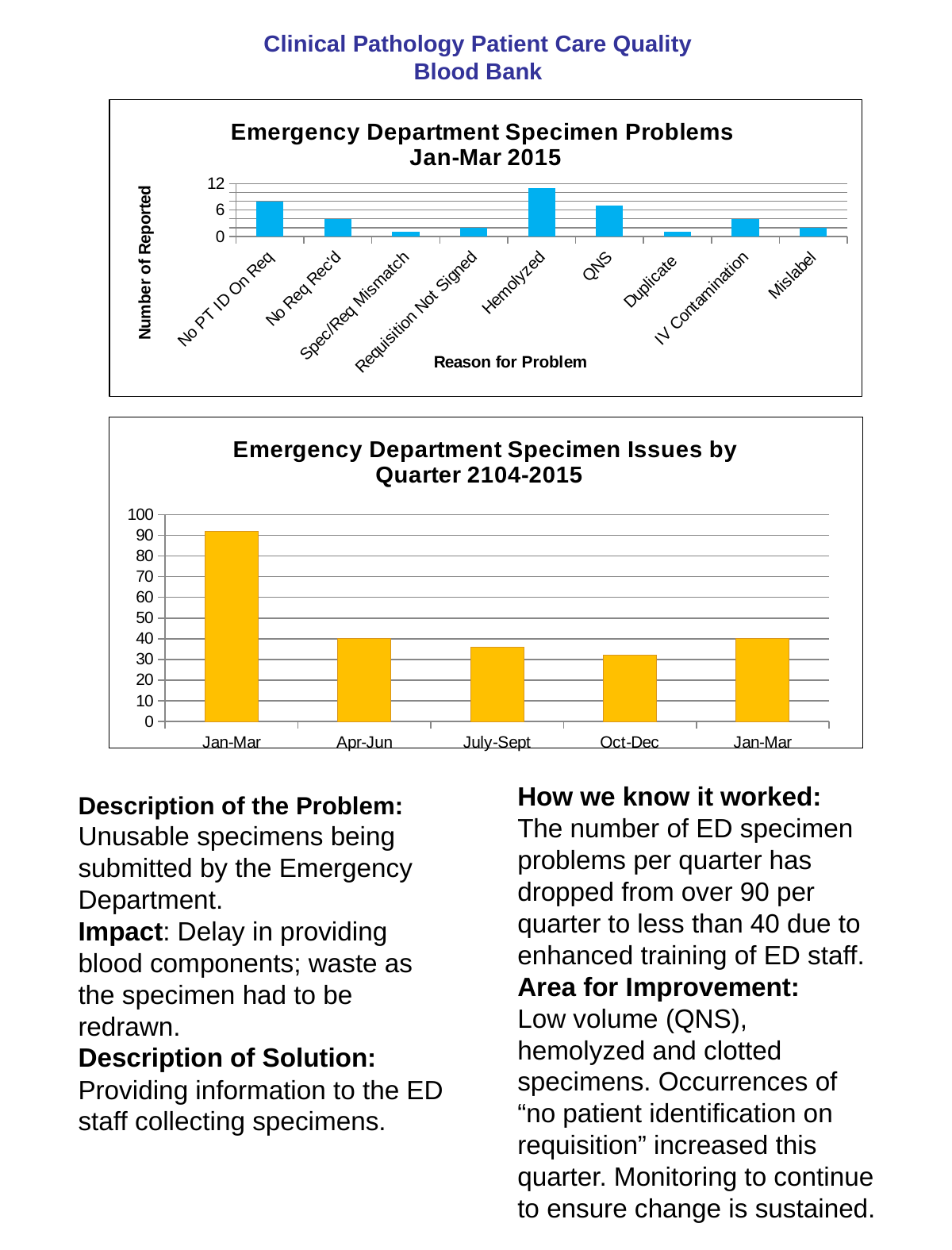
In the top chart 'Emergency Department Specimen Problems Jan-Mar 2015', how many reasons for problem are shown on the x axis? 9 In the top chart 'Emergency Department Specimen Problems Jan-Mar 2015', which is larger, the value for Hemolyzed or the value for QNS? Hemolyzed What is the label of the y axis in the top chart 'Emergency Department Specimen Problems Jan-Mar 2015'? Number of Reported In the bottom chart 'Emergency Department Specimen Issues by Quarter 2104-2015', which quarter has the highest value? Jan-Mar (the first bar) In the top chart 'Emergency Department Specimen Problems Jan-Mar 2015', is the value for Hemolyzed greater or less than 6? greater In the top chart 'Emergency Department Specimen Problems Jan-Mar 2015', is the value for No Req Rec'd greater or less than 6? less In the bottom chart 'Emergency Department Specimen Issues by Quarter 2104-2015', is the value for Oct-Dec greater or less than 40? less In the top chart 'Emergency Department Specimen Problems Jan-Mar 2015', which reason for problem has the highest number reported? Hemolyzed What type of chart is the top chart, 'Emergency Department Specimen Problems Jan-Mar 2015'? bar chart In the bottom chart 'Emergency Department Specimen Issues by Quarter 2104-2015', which quarter has the lowest value? Oct-Dec In the bottom chart 'Emergency Department Specimen Issues by Quarter 2104-2015', how many bars are plotted? 5